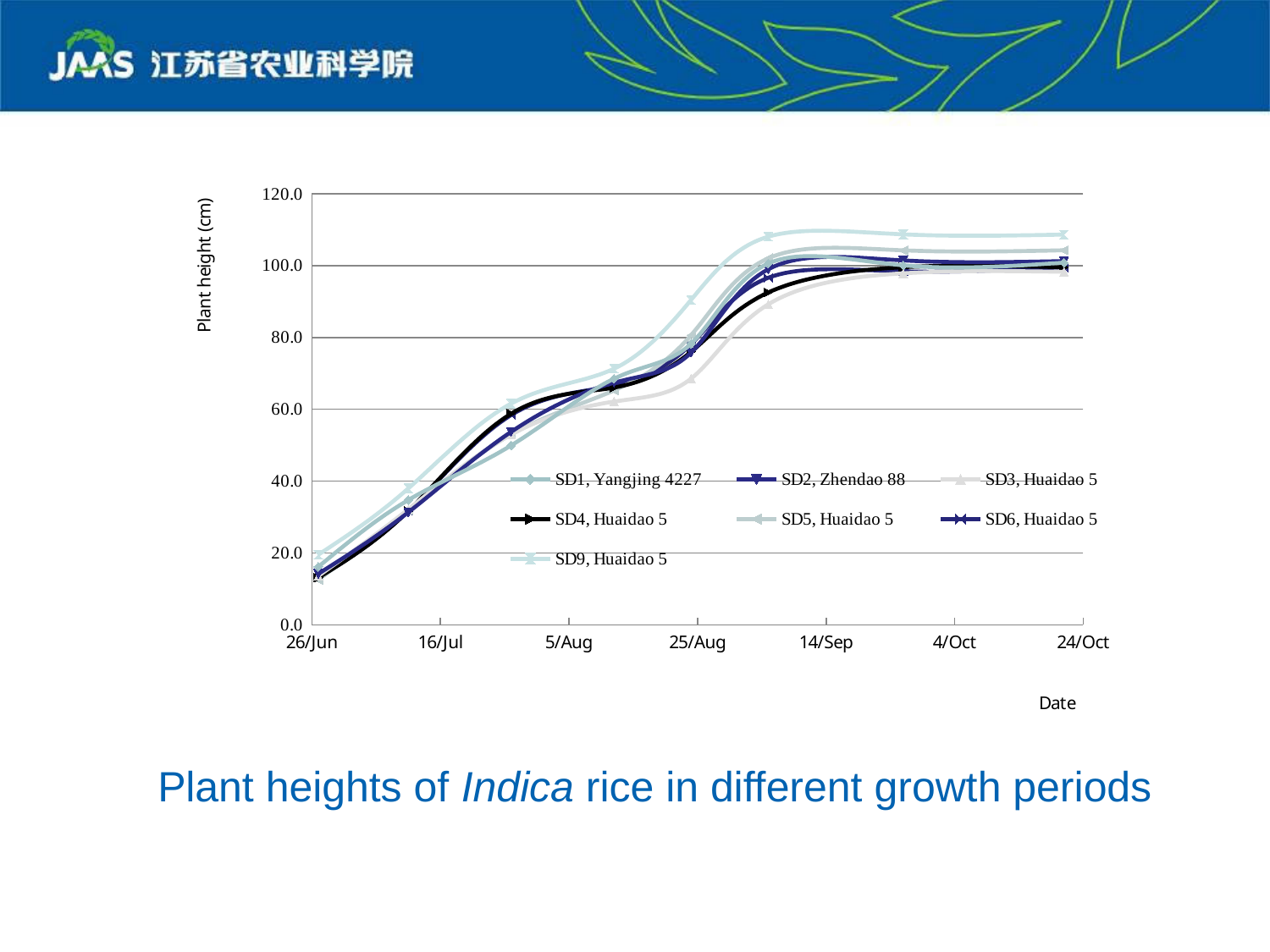
Which series has the highest plant height at 24/Oct? SD9, Huaidao 5 What is the label of the x axis? Date Is the value for SD9, Huaidao 5 at 24/Oct greater or less than 100? greater At 25/Aug, which is larger: the value for SD9, Huaidao 5 or the value for SD3, Huaidao 5? SD9, Huaidao 5 What is the label of the y axis? Plant height (cm) Is the value for SD3, Huaidao 5 at 25/Aug greater or less than 80? less What kind of chart is shown on the slide? line chart Do the plant height values rise or fall from 26/Jun to 24/Oct? rise Is the value for SD9, Huaidao 5 at 25/Aug greater or less than 80? greater How many series does the legend list? 7 How many date labels are shown on the x axis? 7